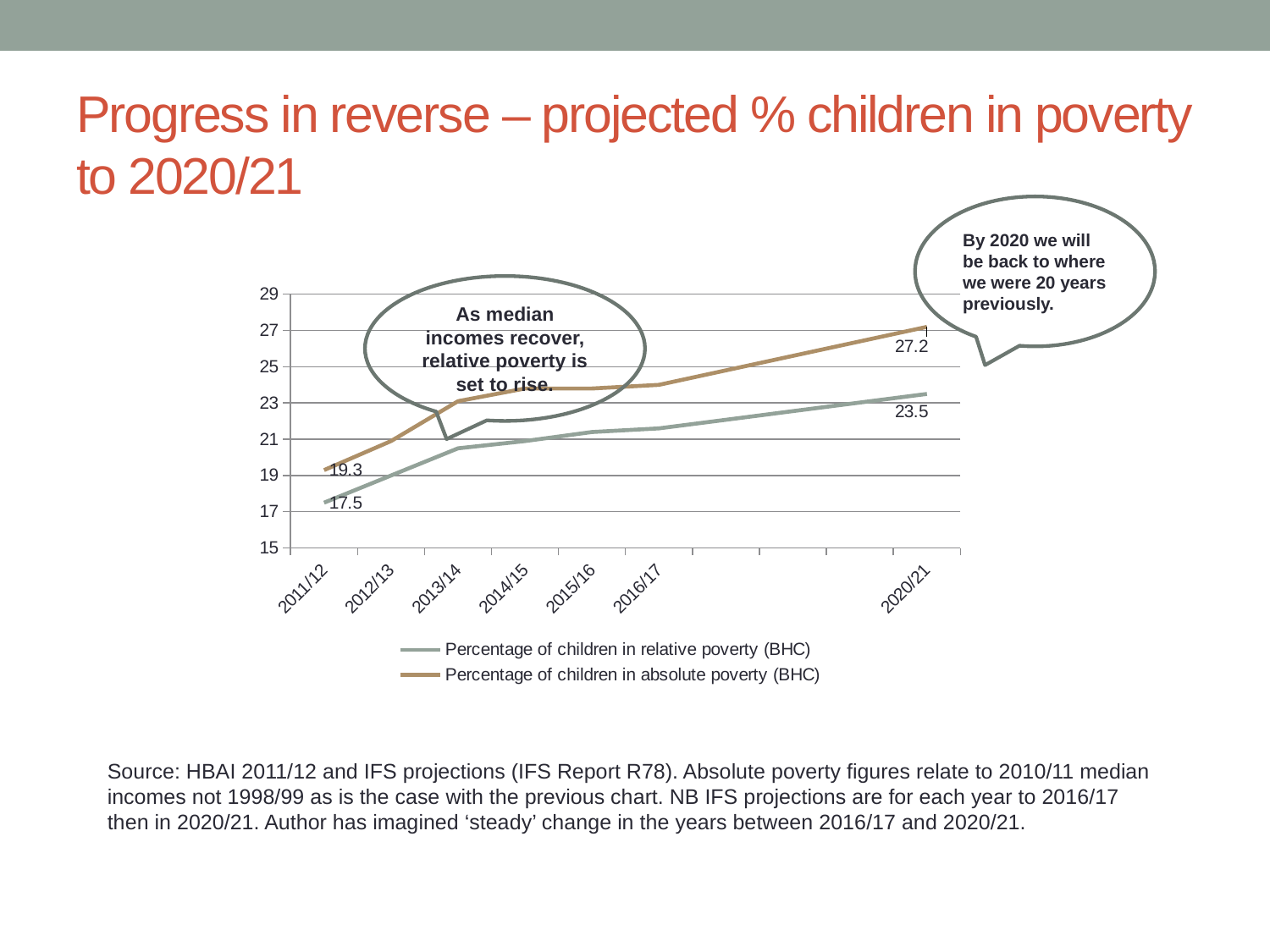
What is the percentage of children in relative poverty (BHC) in 2011/12? 17.5 By how much does the percentage of children in absolute poverty rise between 2011/12 and 2020/21? 7.9 What kind of chart is shown on the slide? Line chart In 2020/21, which is higher: the percentage of children in absolute poverty or in relative poverty? Absolute poverty What is the projected percentage of children in absolute poverty (BHC) in 2020/21? 27.2 Do the percentages of children in relative poverty rise or fall from 2011/12 to 2020/21? Rise Is the percentage of children in relative poverty in 2016/17 greater or less than 23? less Is the percentage of children in absolute poverty in 2013/14 greater or less than 21? greater What is the difference between the absolute poverty and relative poverty percentages in 2020/21? 3.7 What is the projected percentage of children in relative poverty (BHC) in 2020/21? 23.5 How many series does the legend list? 2 What is the percentage of children in absolute poverty (BHC) in 2011/12? 19.3